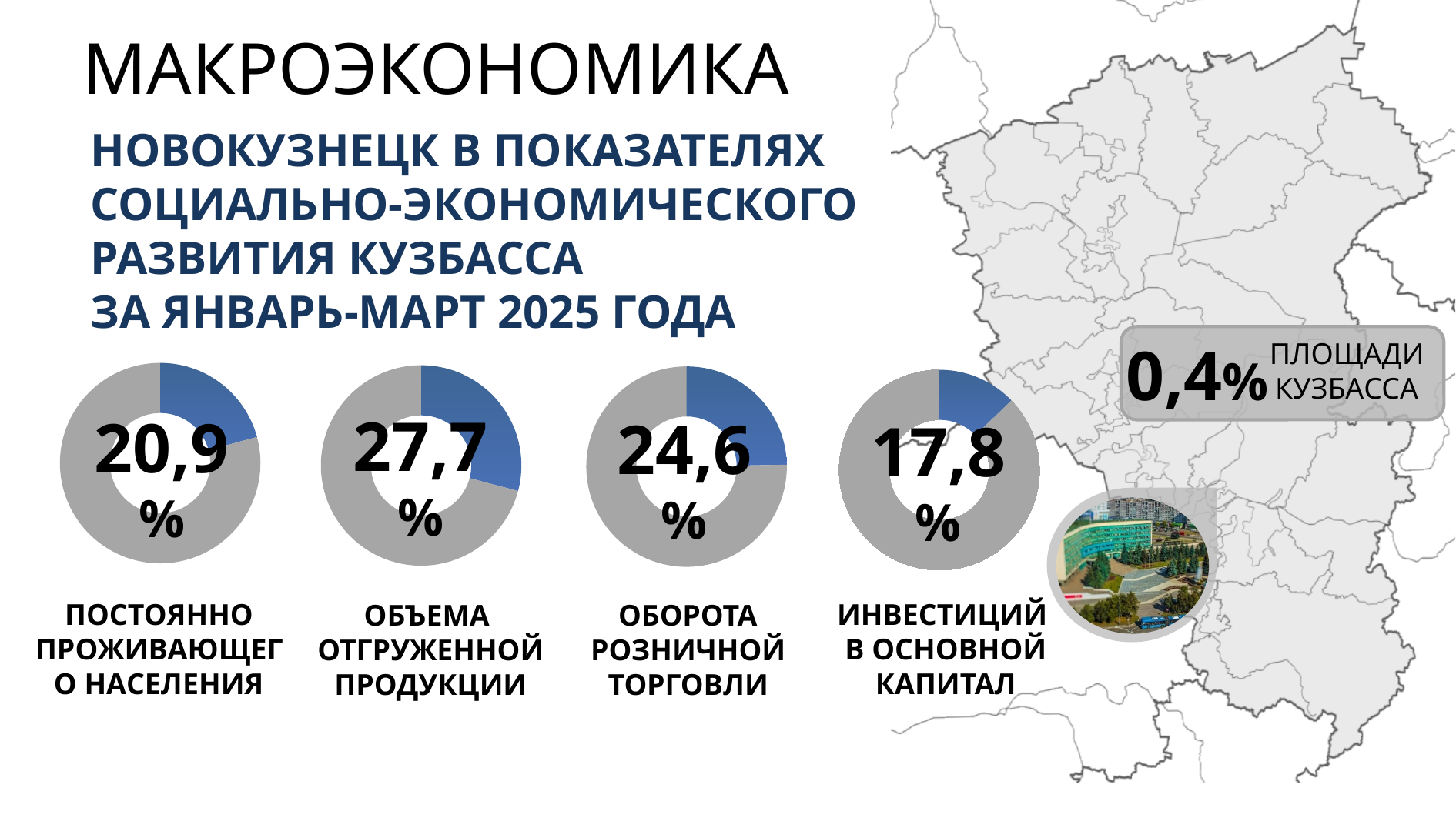
What is the difference between the value for оборота розничной торговли and the value for инвестиций в основной капитал? 6,8% Which of the four donut charts shows the highest value? Объема отгруженной продукции What value is shown in the donut chart for объема отгруженной продукции? 27,7% What kind of chart is used to show the four indicators on the slide? Donut (pie) chart What value is shown in the donut chart for постоянно проживающего населения? 20,9% Which of the four donut charts shows the lowest value? Инвестиций в основной капитал What value is shown in the donut chart for инвестиций в основной капитал? 17,8% What value is shown in the donut chart for оборота розничной торговли? 24,6% How many donut charts are shown on the slide? 4 What is the difference between the value for объема отгруженной продукции and the value for постоянно проживающего населения? 6,8% Which is larger: the value for оборота розничной торговли or the value for постоянно проживающего населения? Оборота розничной торговли What colour is the slice representing the indicator value in each donut chart? Blue